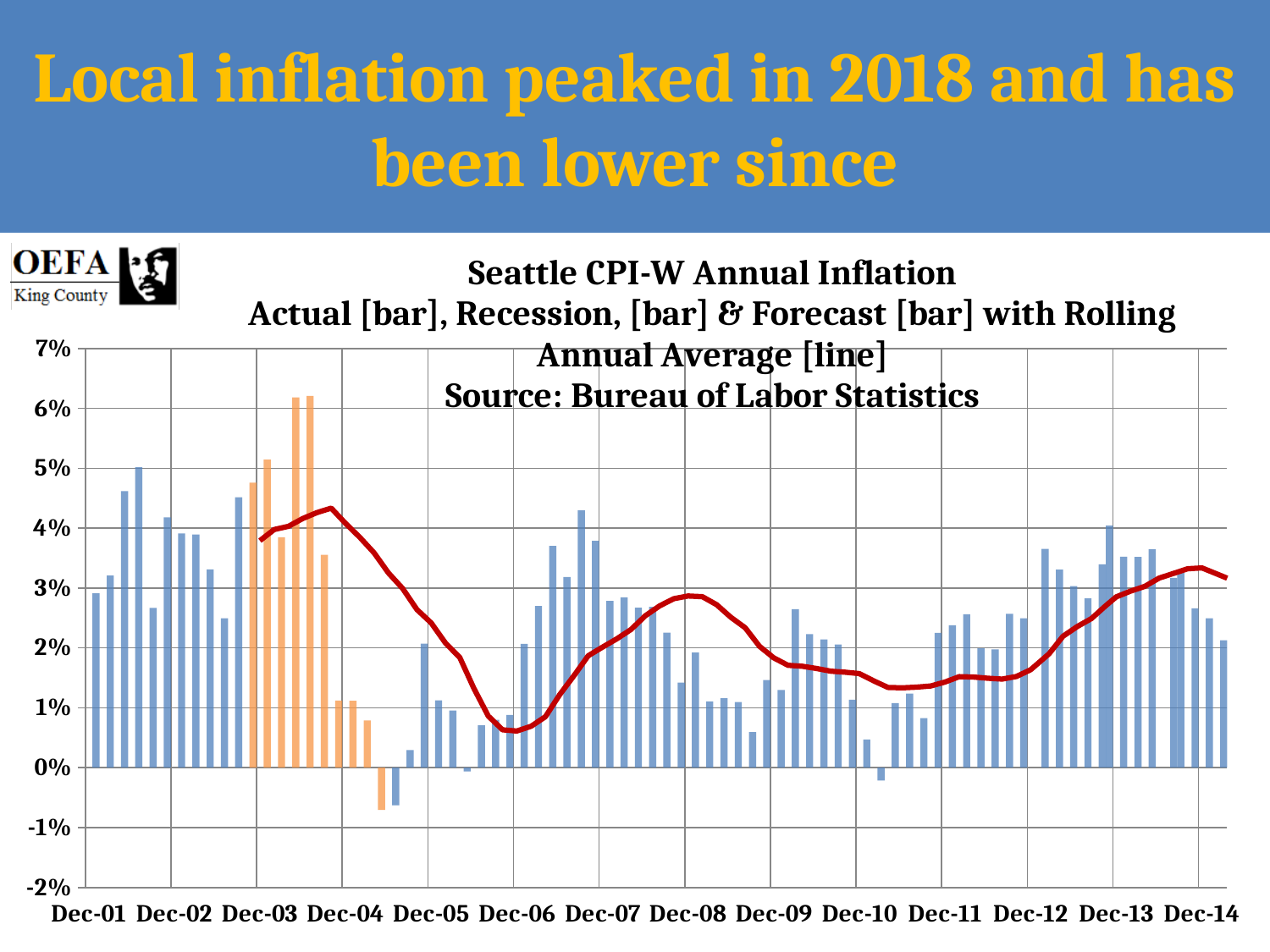
Is the value of the bar at Dec-14 greater or less than 3%? less Does the rolling annual average line rise or fall between Dec-10 and Dec-14? rise What is the source of the data cited in the chart title? Bureau of Labor Statistics Is the value of the bar at Dec-10 greater or less than 2%? less Is the value of the bar at Dec-03 greater or less than 4%? greater Does the rolling annual average line rise or fall between Dec-04 and Dec-06? fall What kind of chart is shown on the slide? A combined bar and line chart How many labelled dates appear on the x axis? 14 What does the red line in the chart represent, according to the title? Rolling Annual Average